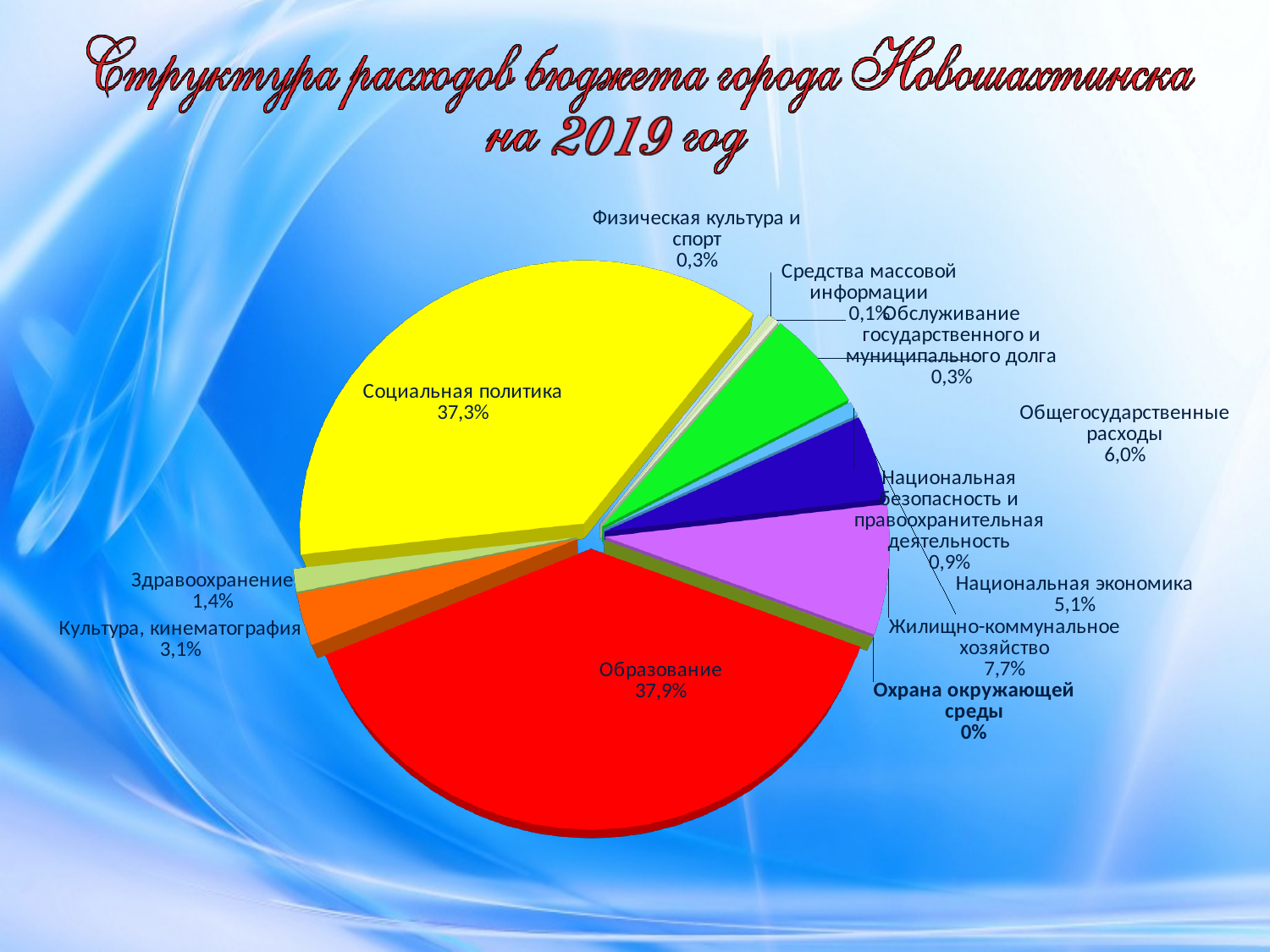
What share of the budget expenditure goes to Образование? 37,9% What colour is the Образование slice? Red How many categories are shown in the pie chart? 12 What type of chart is shown on the slide? Pie chart What is the value shown for Национальная экономика? 5,1% By how many percentage points does Образование exceed Социальная политика? 0,6 What is the value shown for Средства массовой информации? 0,1% What share of the budget expenditure goes to Социальная политика? 37,3% Which is larger: Жилищно-коммунальное хозяйство or Общегосударственные расходы? Жилищно-коммунальное хозяйство Which category has the largest share of the pie? Образование Which category has the smallest share of the pie? Охрана окружающей среды What is the value shown for Жилищно-коммунальное хозяйство? 7,7%